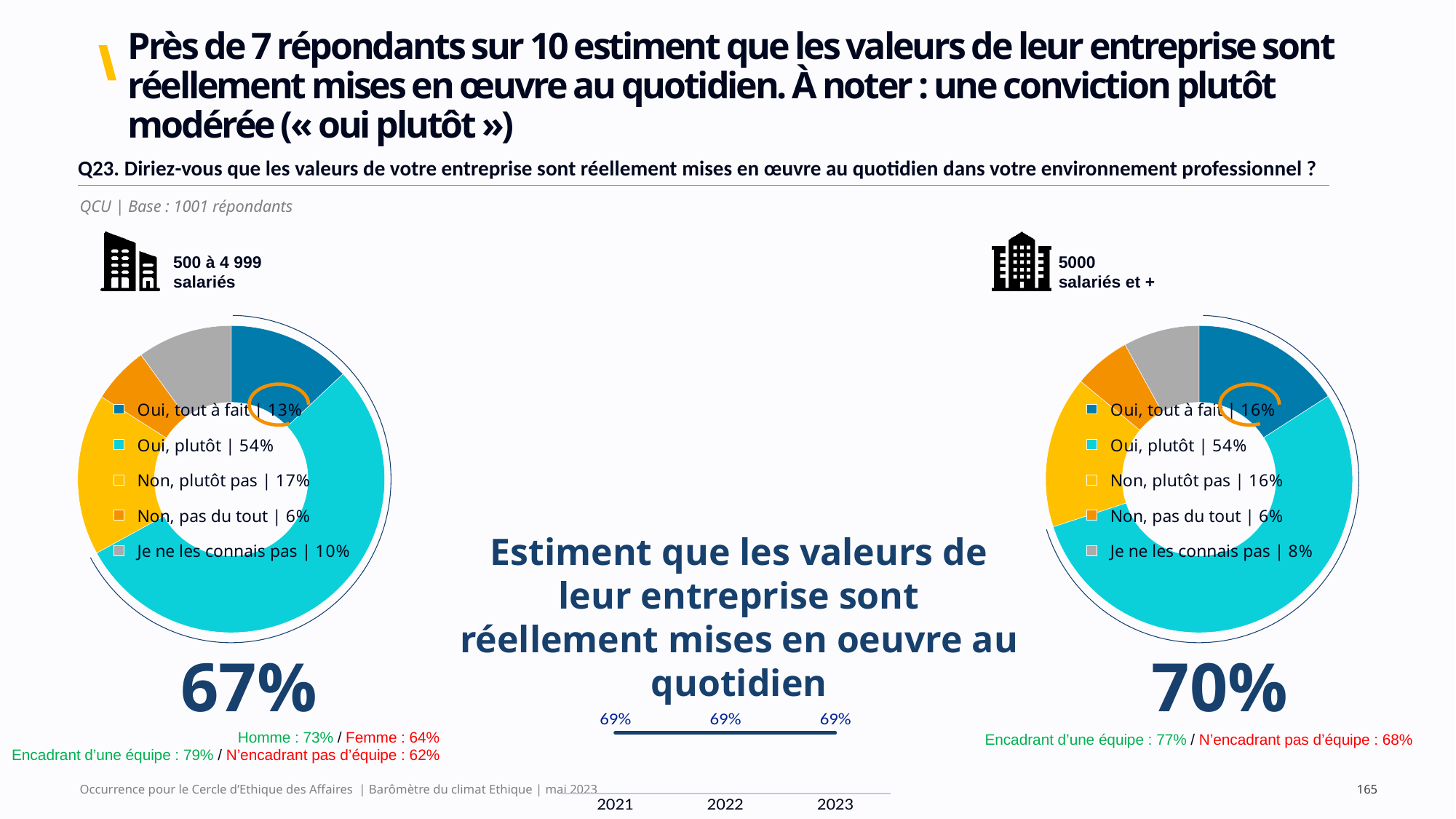
In the '500 à 4 999 salariés' chart, what is the value for 'Oui, tout à fait'? 13% In the '5000 salariés et +' chart, which category has the smallest share? Non, pas du tout Which is larger: 'Oui, tout à fait' in the '500 à 4 999 salariés' chart or 'Oui, tout à fait' in the '5000 salariés et +' chart? 5000 salariés et + In the '500 à 4 999 salariés' chart, what colour is the 'Oui, plutôt' segment? Turquoise (light blue) In the '500 à 4 999 salariés' chart, what is the difference between 'Non, plutôt pas' and 'Non, pas du tout'? 11 points In the line chart at the bottom centre, what is the value for 2022? 69% In the line chart at the bottom centre, do the values rise, fall or stay flat from 2021 to 2023? Stay flat In the '5000 salariés et +' chart, what is the combined share of 'Oui, tout à fait' and 'Oui, plutôt'? 70% How many categories does the '500 à 4 999 salariés' chart show? 5 In the '500 à 4 999 salariés' chart, which category has the largest share? Oui, plutôt In the '5000 salariés et +' chart, what is the value for 'Je ne les connais pas'? 8% What kind of chart is used for the '5000 salariés et +' data? Donut (pie) chart